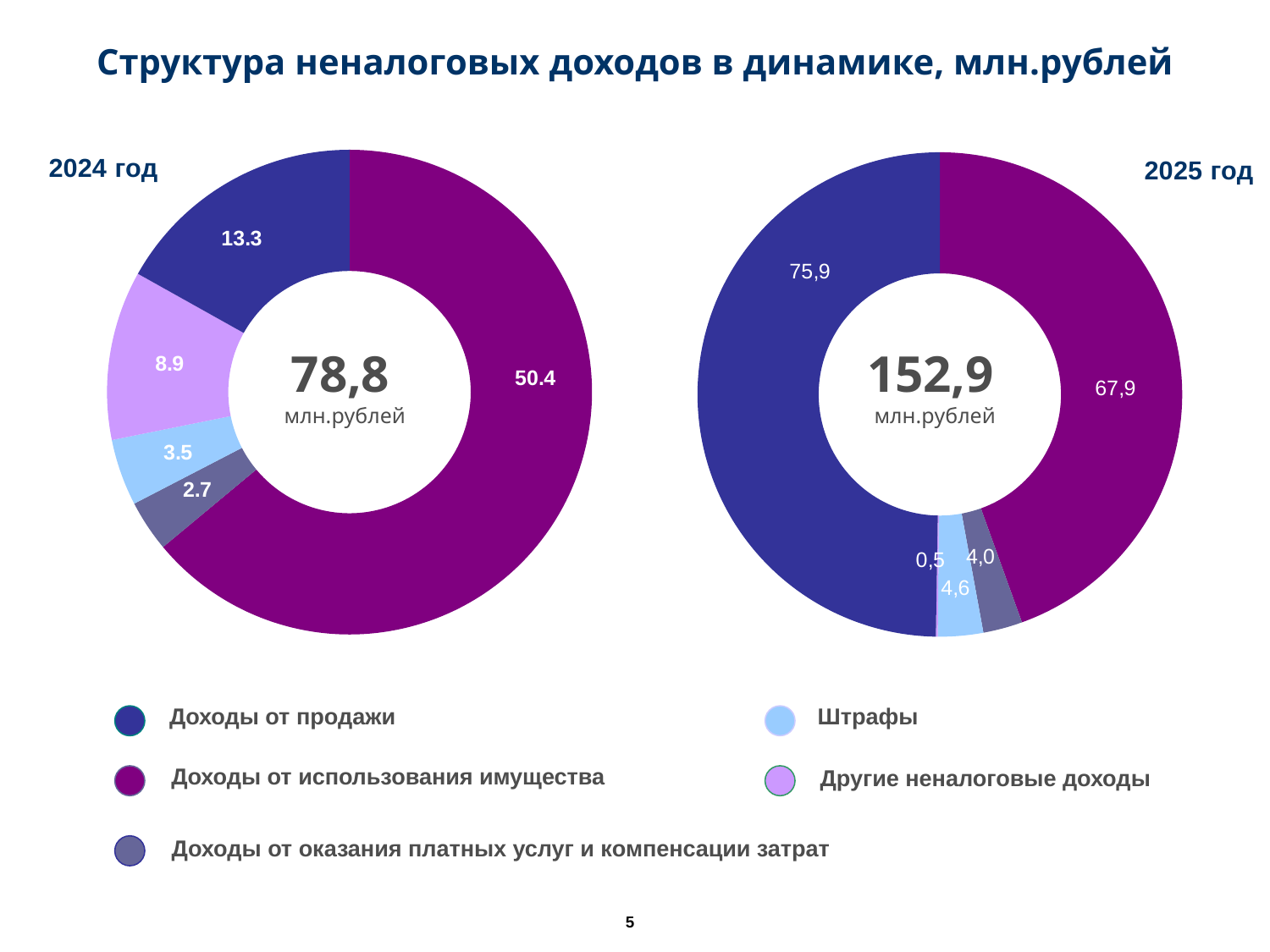
In the 2024 год chart, what is the value for Штрафы? 3.5 In the 2024 год chart, which category has the smallest value? Доходы от оказания платных услуг и компенсации затрат How many categories does the legend list? 5 In the 2024 год chart, which category has the largest value? Доходы от использования имущества What type of chart is used on this slide? Donut (pie) chart In the 2025 год chart, which is larger: Штрафы or Доходы от оказания платных услуг и компенсации затрат? Штрафы In the 2025 год chart, what is the value for Доходы от продажи? 75,9 In the 2025 год chart, what is the difference between Доходы от продажи and Доходы от использования имущества? 8,0 What is the total shown in the centre of the 2025 год chart? 152,9 млн.рублей In the 2025 год chart, which category has the smallest value? Другие неналоговые доходы In the 2024 год chart, what is the value for Доходы от использования имущества? 50.4 In the 2025 год chart, what is the value for Другие неналоговые доходы? 0,5